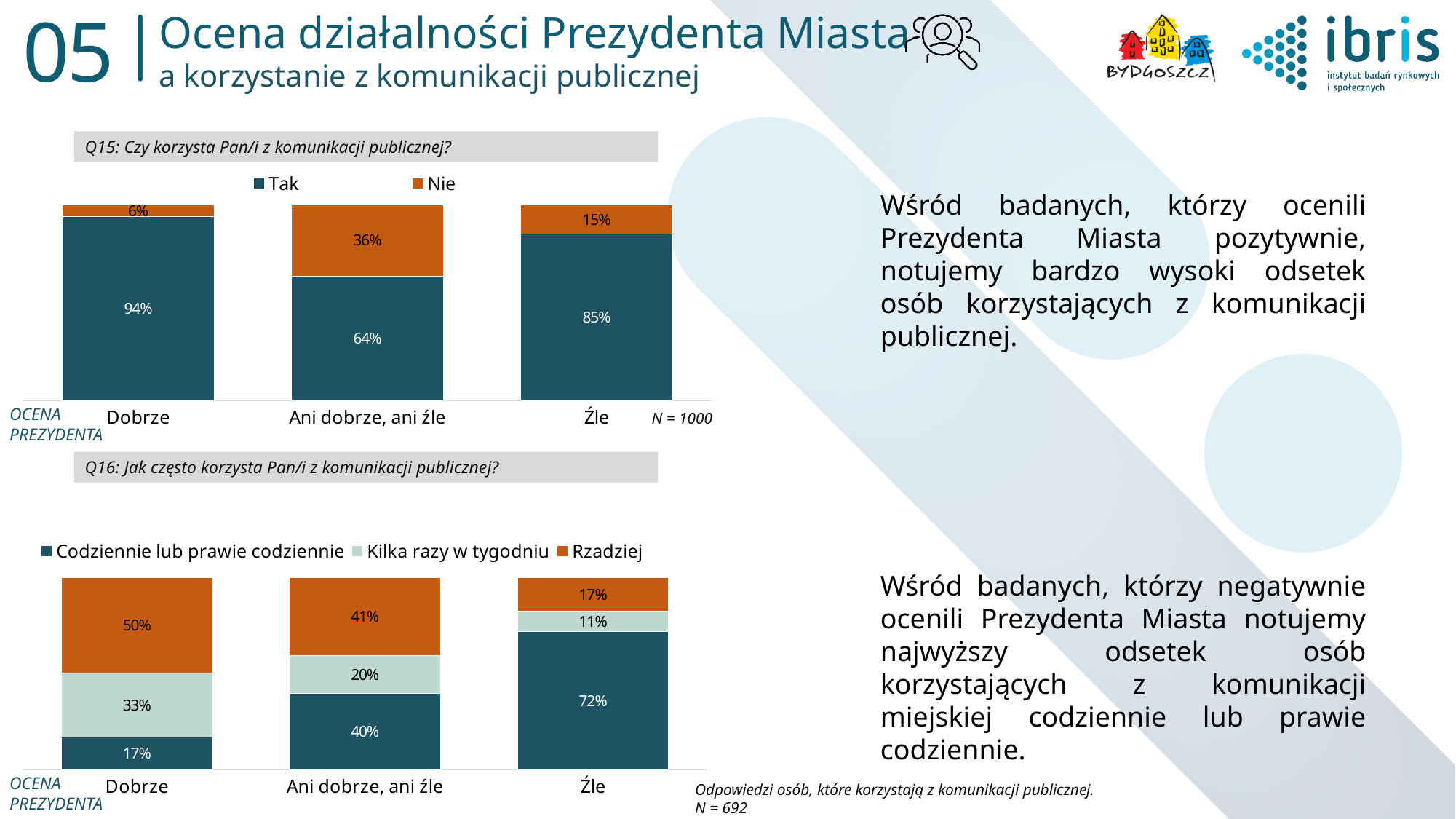
In the Q15 chart (top), how many series does the legend list? 2 In the Q16 chart (bottom), how many rating categories are shown on the x axis? 3 What type of chart is the Q16 chart (bottom)? Stacked bar chart In the Q15 chart (top), what percentage of respondents who rated the mayor 'Dobrze' answered 'Tak'? 94% In the Q16 chart (bottom), what is the 'Codziennie lub prawie codziennie' value for the 'Źle' group? 72% In the Q16 chart (bottom), what is the 'Kilka razy w tygodniu' value for the 'Dobrze' group? 33% In the Q15 chart (top), what is the 'Nie' value for the 'Ani dobrze, ani źle' group? 36% In the Q16 chart (bottom), is the 'Codziennie lub prawie codziennie' value larger for 'Dobrze' or for 'Ani dobrze, ani źle'? Ani dobrze, ani źle In the Q16 chart (bottom), which rating group has the highest 'Rzadziej' share? Dobrze In the Q16 chart (bottom), what is the difference between the 'Rzadziej' values for 'Dobrze' and 'Źle'? 33 percentage points In the Q15 chart (top), what is the difference between the 'Tak' values for 'Dobrze' and 'Źle'? 9 percentage points In the Q15 chart (top), which rating group has the lowest 'Tak' share? Ani dobrze, ani źle